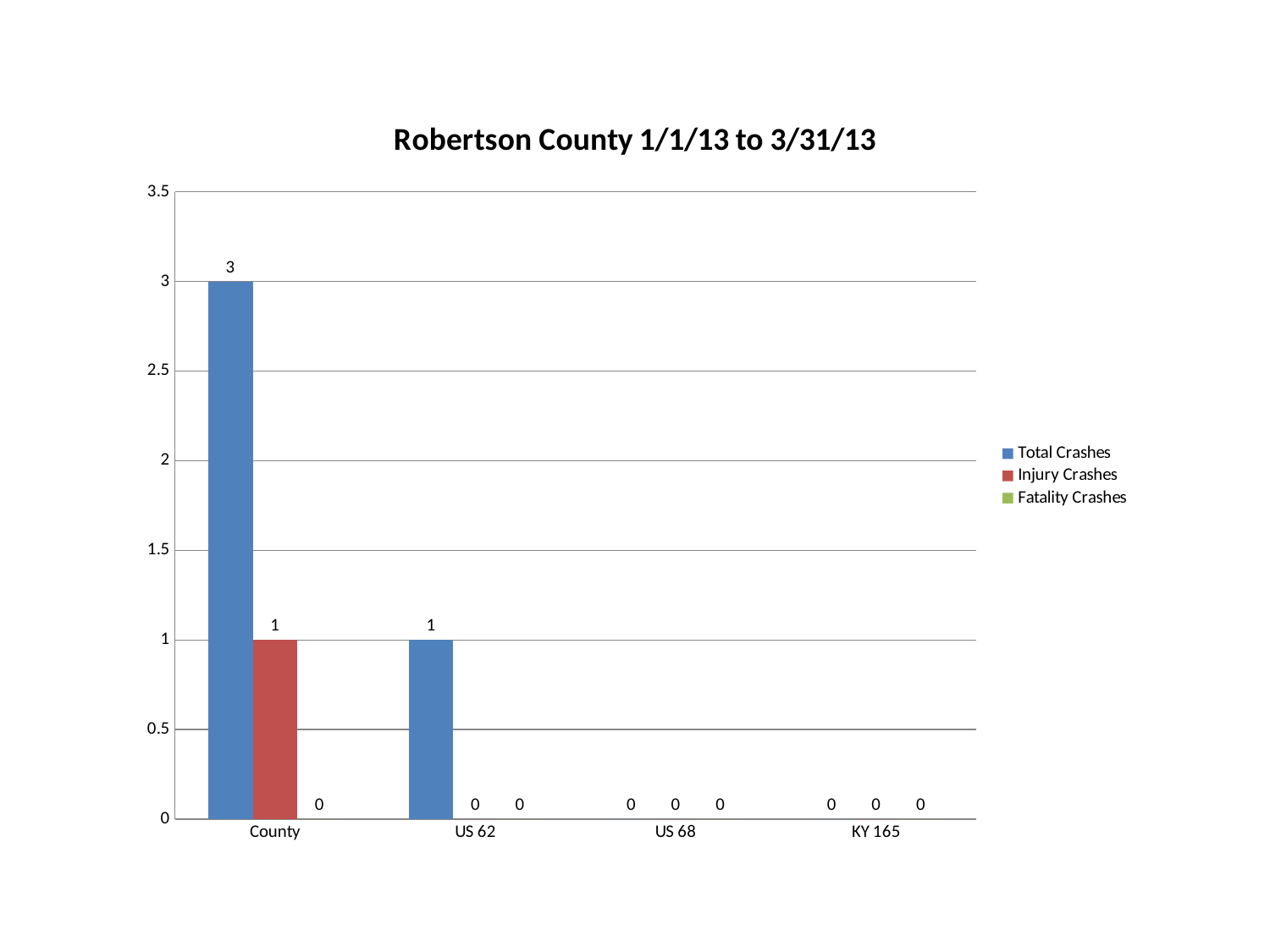
Which category has the highest Total Crashes value? County What is the difference between Total Crashes and Injury Crashes for County? 2 Which series is shown in red in the legend? Injury Crashes What is the value of Fatality Crashes for KY 165? 0 What is the value of Total Crashes for County? 3 What is the title of the chart? Robertson County 1/1/13 to 3/31/13 What kind of chart is shown on the slide? Bar chart How many series does the legend list? 3 How many categories are shown on the x axis? 4 Which is larger: Total Crashes for County or Total Crashes for US 62? Total Crashes for County What is the value of Total Crashes for US 62? 1 What is the value of Injury Crashes for County? 1